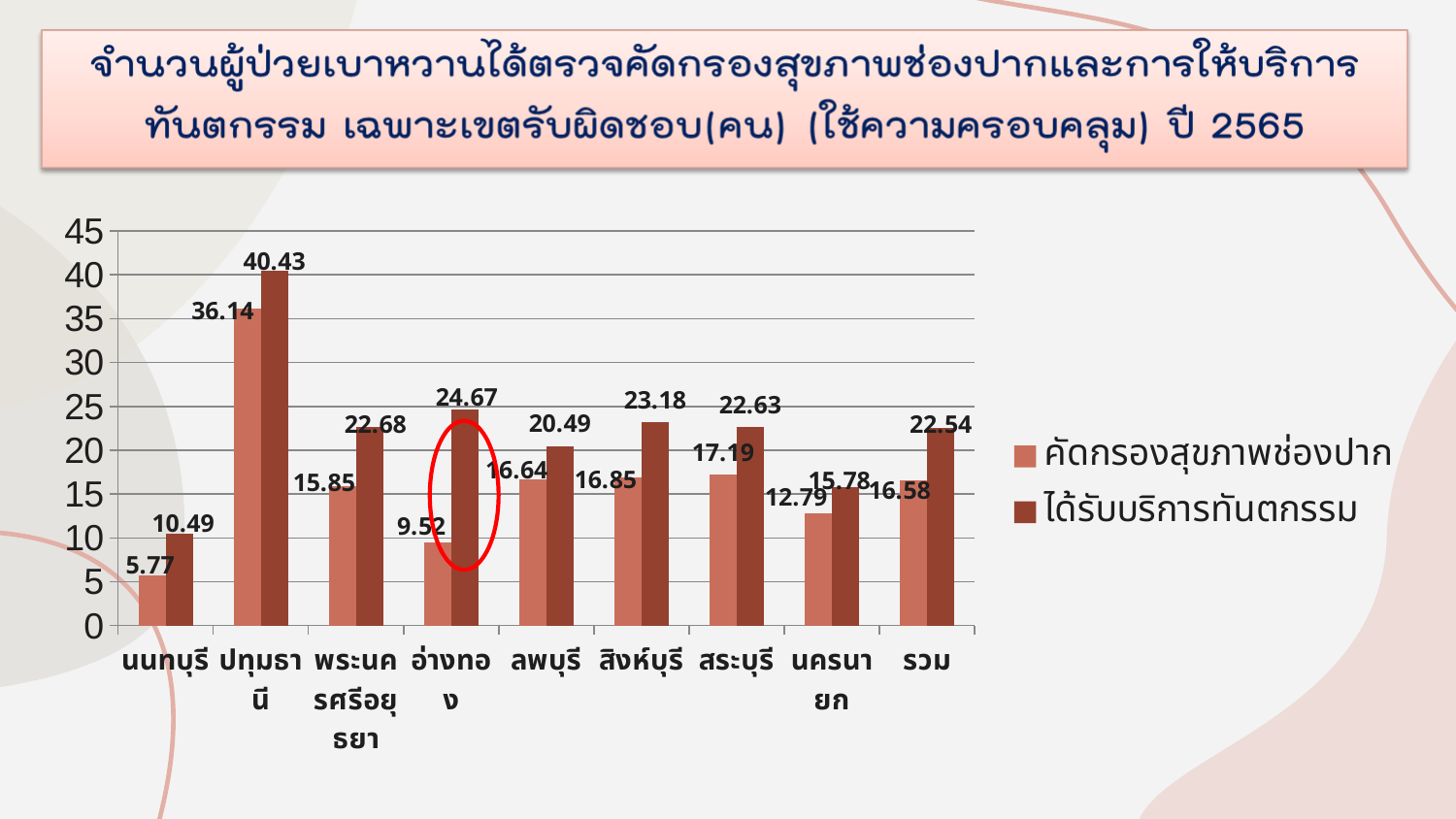
What is the value of ได้รับบริการทันตกรรม for อ่างทอง? 24.67 Which is larger for สระบุรี: คัดกรองสุขภาพช่องปาก or ได้รับบริการทันตกรรม? ได้รับบริการทันตกรรม How many series does the legend list? 2 What is the value of คัดกรองสุขภาพช่องปาก for ปทุมธานี? 36.14 What kind of chart is shown on the slide? bar chart Which province has the lowest value for คัดกรองสุขภาพช่องปาก? นนทบุรี How many categories are shown on the x axis? 9 Is the value of ได้รับบริการทันตกรรม for นครนายก greater or less than 20? less What is the difference between ได้รับบริการทันตกรรม and คัดกรองสุขภาพช่องปาก for อ่างทอง? 15.15 Which category is circled in red on the chart? อ่างทอง What is the value of ได้รับบริการทันตกรรม for รวม? 22.54 Which province has the highest value for ได้รับบริการทันตกรรม? ปทุมธานี